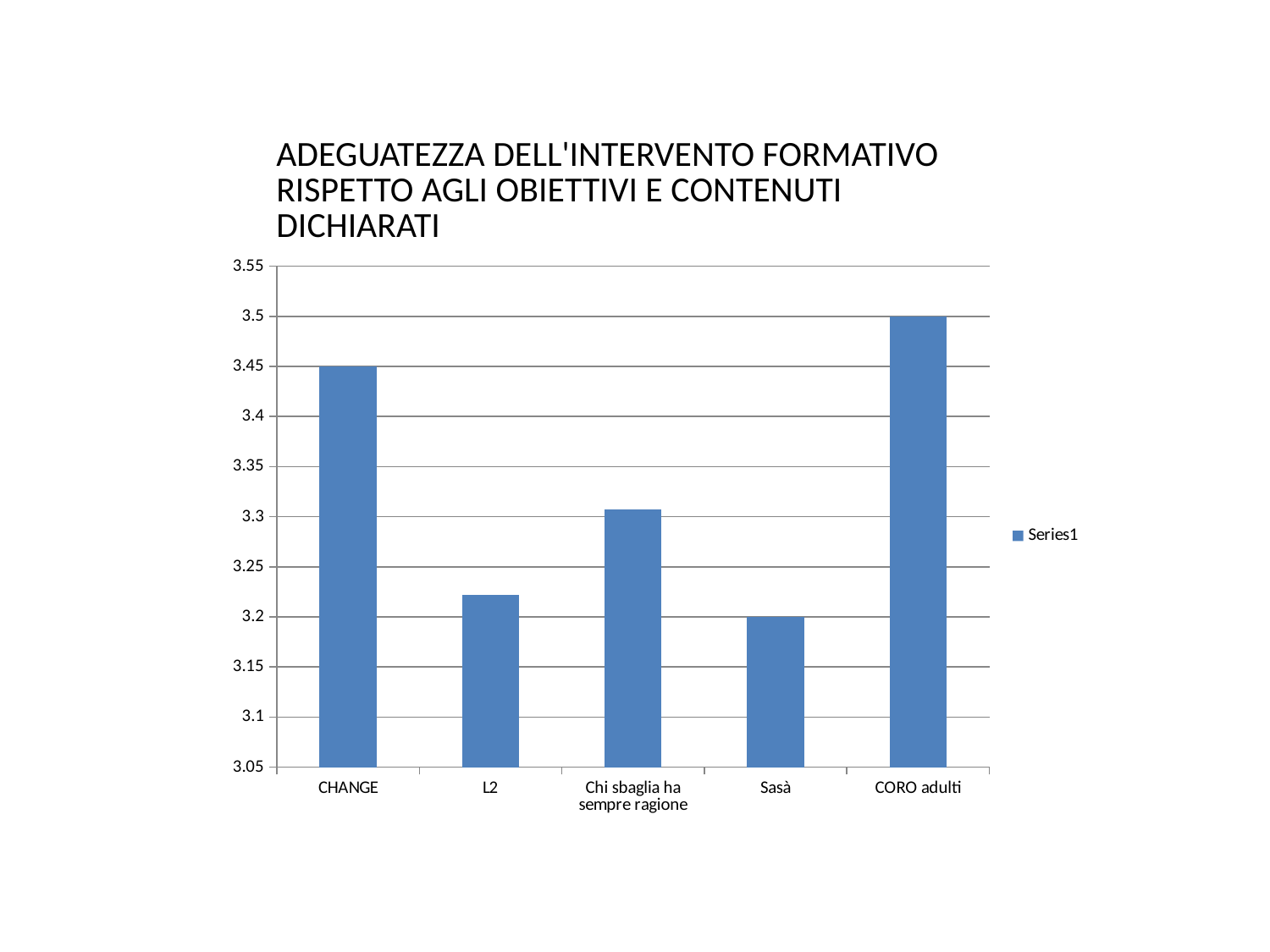
Which is larger, the value for CHANGE or the value for Chi sbaglia ha sempre ragione? CHANGE What is the difference between the values for CORO adulti and CHANGE? 0.05 What is the name of the series shown in the legend? Series1 What is the value for Sasà? 3.2 What kind of chart is shown on the slide? bar chart Which category has the highest value in the chart? CORO adulti What is the value for CORO adulti? 3.5 What is the value for CHANGE? 3.45 How many categories are shown on the x axis of the chart? 5 How many series does the legend list? 1 Is the value for L2 greater or less than 3.25? less